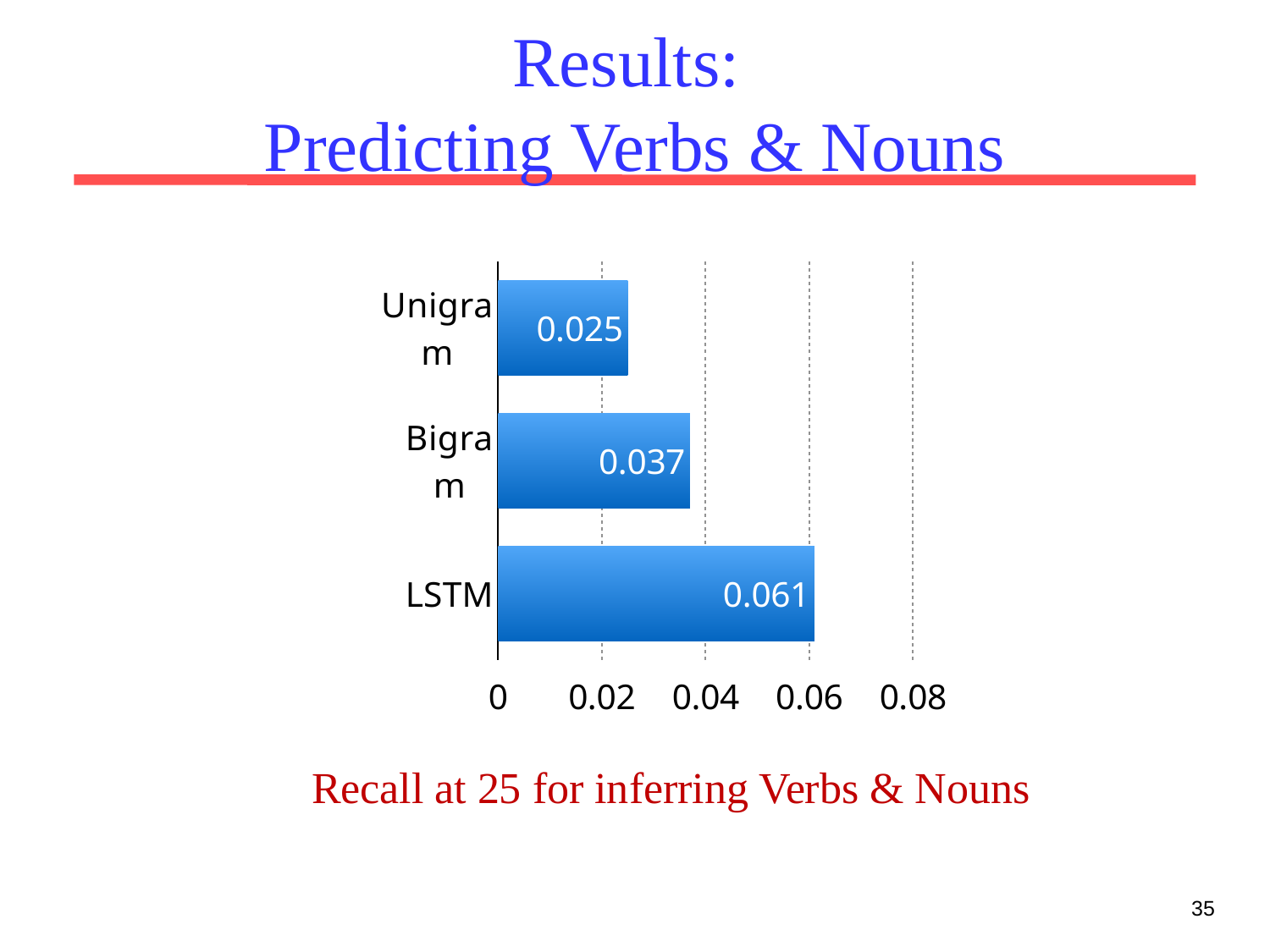
Which category has the highest value? LSTM What does the caption below the chart say the values represent? Recall at 25 for inferring Verbs & Nouns What is the value for Bigram? 0.037 What is the difference between the values for LSTM and Bigram? 0.024 What is the value for LSTM? 0.061 Is the value for LSTM greater or less than 0.04? greater What is the difference between the values for Bigram and Unigram? 0.012 Which category has the lowest value? Unigram What is the value for Unigram? 0.025 What kind of chart is shown on the slide? bar chart How many categories are shown in the chart? 3 Which is larger, the value for Bigram or the value for Unigram? Bigram